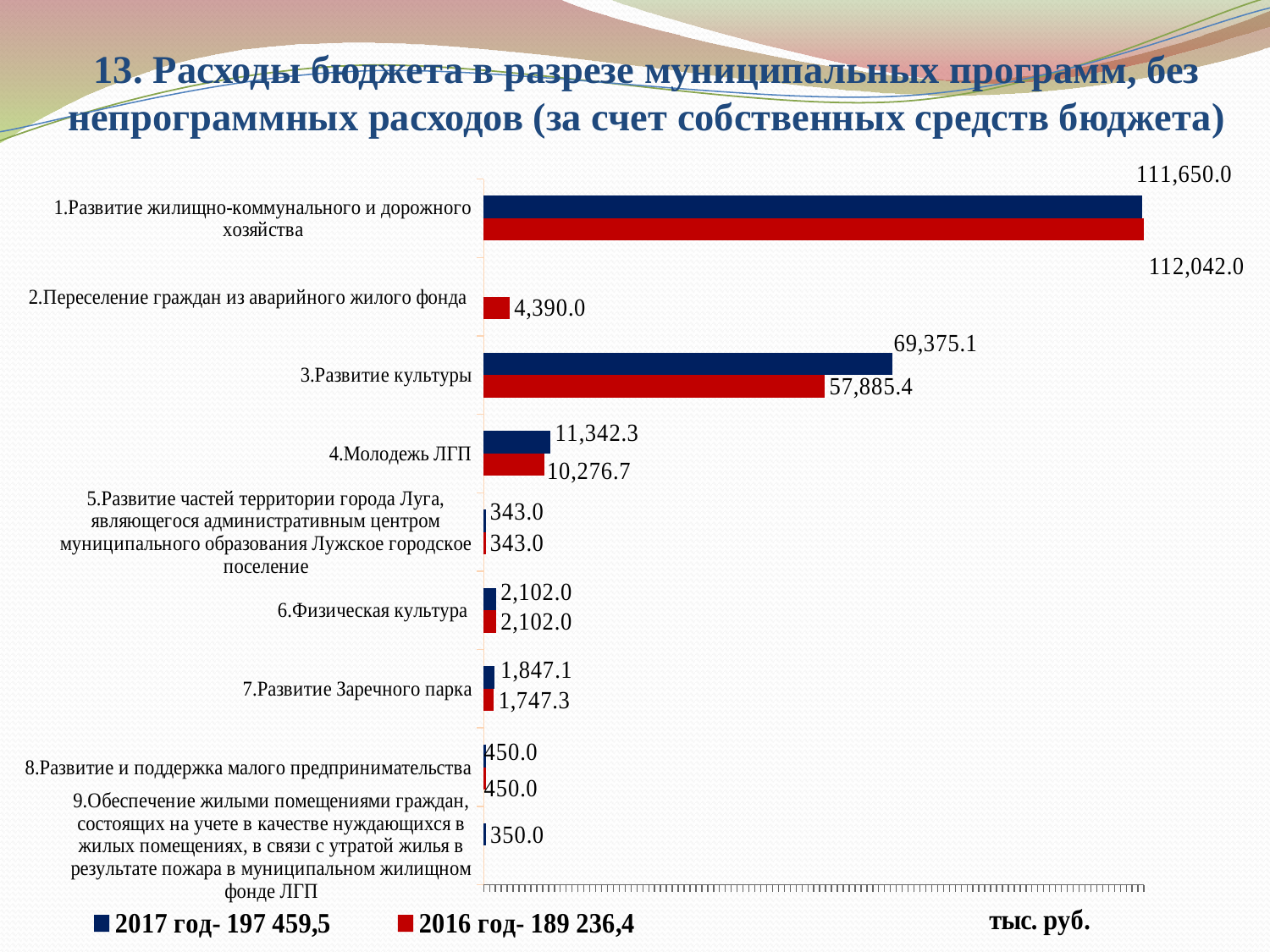
What is the 2016 value for "3.Развитие культуры"? 57,885.4 What is the 2017 value for "4.Молодежь ЛГП"? 11,342.3 What is the difference between the 2017 and 2016 values for "3.Развитие культуры"? 11,489.7 How many series does the legend list? 2 What is the 2016 value for "2.Переселение граждан из аварийного жилого фонда"? 4,390.0 What is the 2017 value for "3.Развитие культуры"? 69,375.1 For "1.Развитие жилищно-коммунального и дорожного хозяйства", which year has the larger value, 2017 or 2016? 2016 Which category has the highest 2017 value? 1.Развитие жилищно-коммунального и дорожного хозяйства What is the difference between the 2017 and 2016 values for "4.Молодежь ЛГП"? 1,065.6 What type of chart is shown on the slide? bar chart What total is shown in the legend for the 2017 год series? 197 459,5 What is the 2016 value for "7.Развитие Заречного парка"? 1,747.3